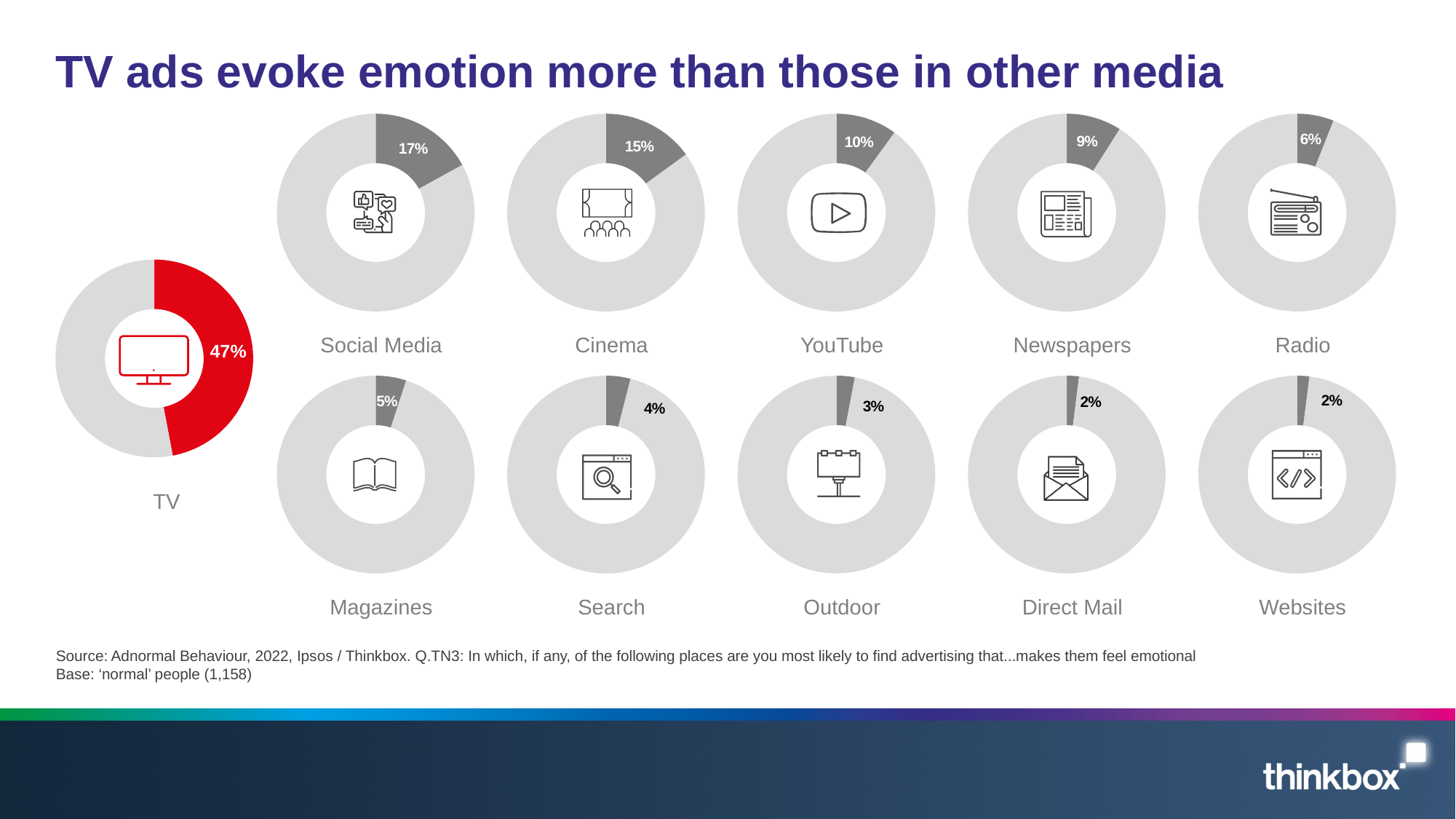
What percentage is shown for TV? 47% What percentage is shown for Social Media? 17% How many media categories are shown on the slide? 11 What percentage is shown for Outdoor? 3% What kind of chart is used for each medium on the slide? Donut chart Which has a higher percentage, Cinema or Newspapers? Cinema What is the difference between the TV percentage and the Social Media percentage? 30% Which has a higher percentage, Radio or Magazines? Radio Which medium has the highest percentage on the slide? TV Which two media share the lowest percentage of 2%? Direct Mail and Websites What percentage is shown for Newspapers? 9% What is the difference between the Cinema percentage and the YouTube percentage? 5%